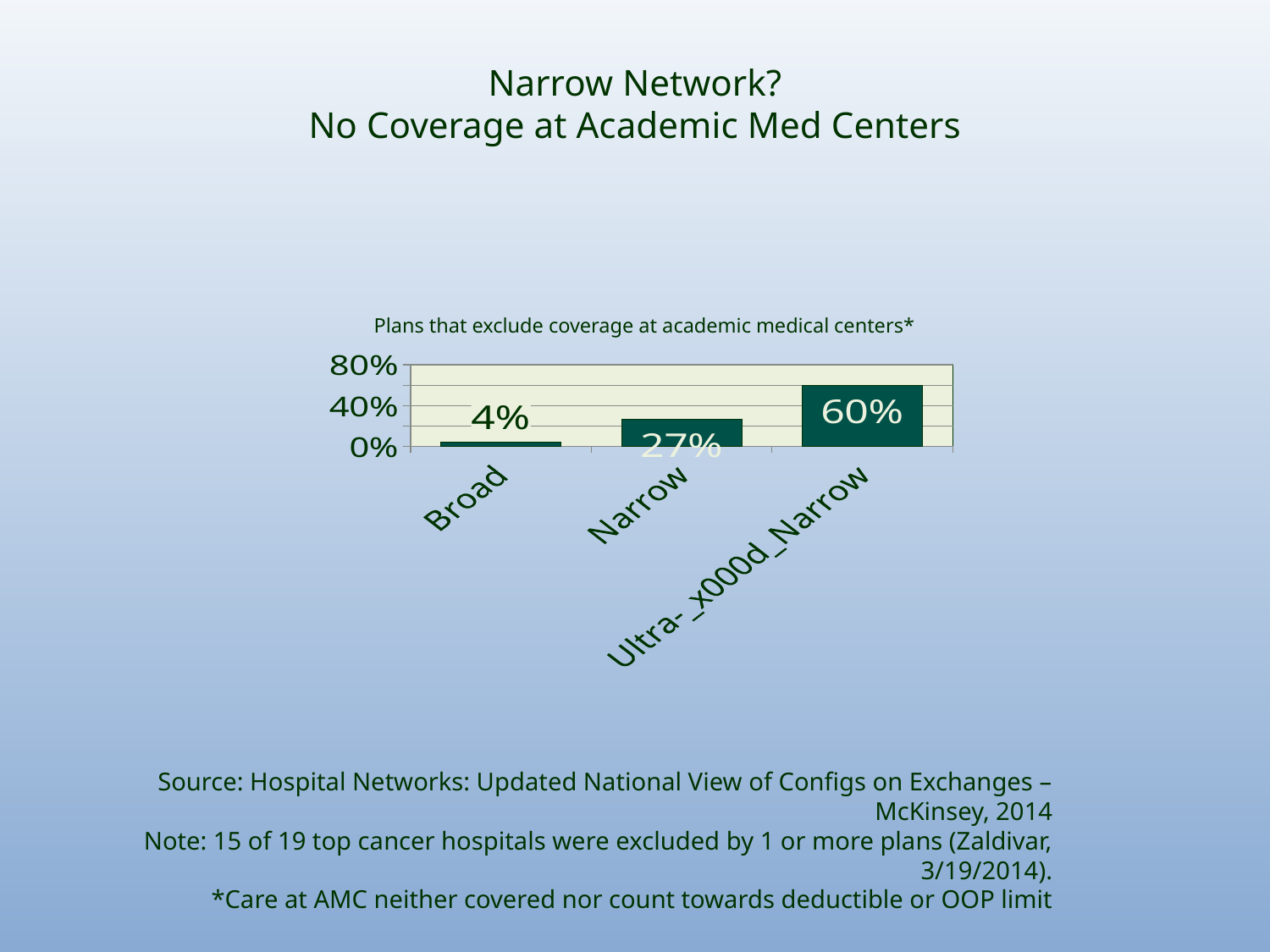
Which category has the highest value? Ultra-Narrow What is the value for Broad plans? 4% Do the values rise or fall moving from Broad to Ultra-Narrow along the x axis? rise What is the difference between the Narrow value and the Broad value? 23% How many categories are shown on the x axis? 3 What kind of chart is shown on the slide? bar chart What is the difference between the Ultra-Narrow value and the Narrow value? 33% What is the value for the Ultra-Narrow category (the third bar)? 60% Which is larger, the value for Narrow or the value for Broad? Narrow What is the value for Narrow plans? 27% Is the value for Ultra-Narrow greater or less than 40%? greater Which category has the lowest value? Broad